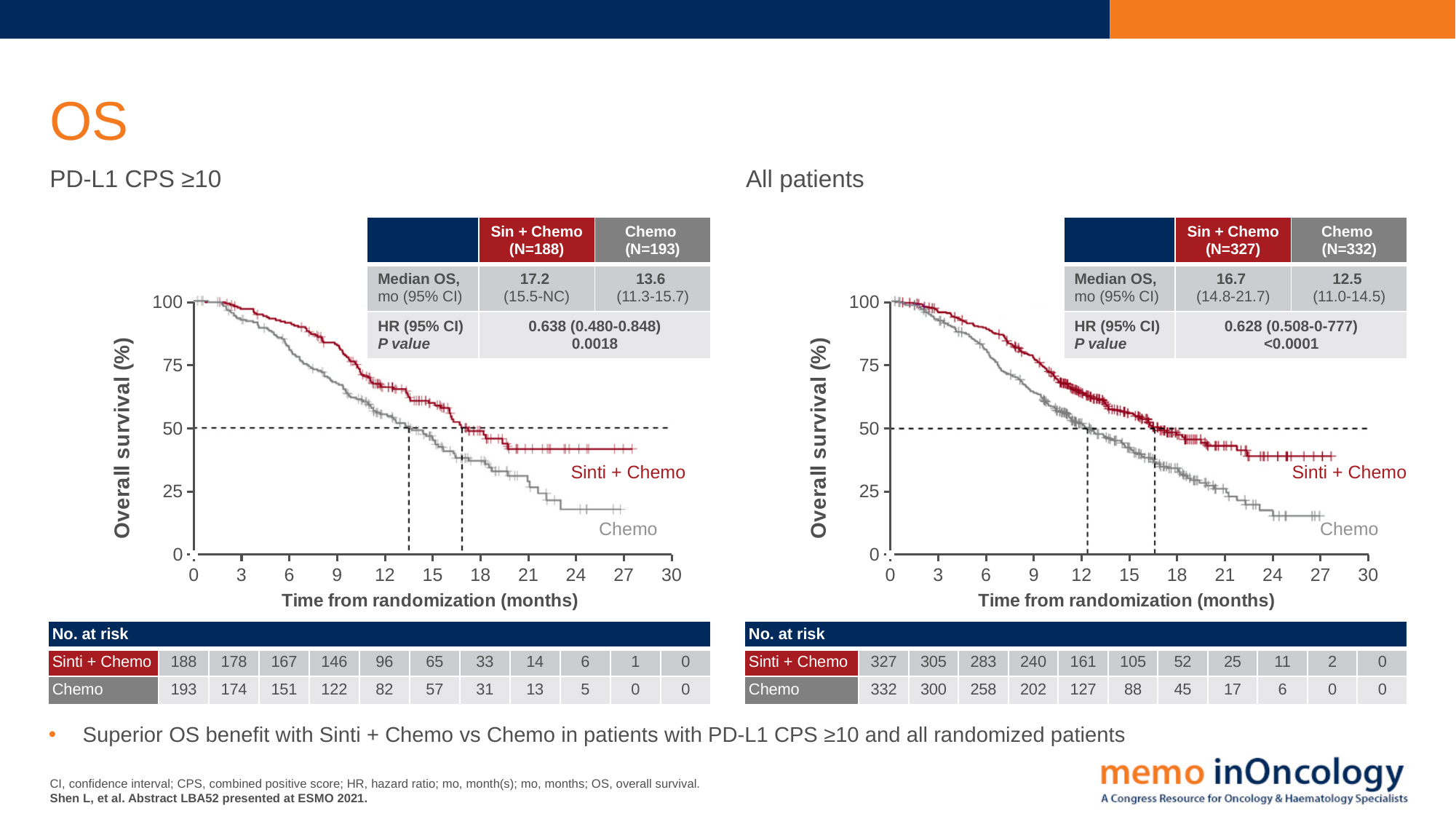
How many treatment arms are plotted in each chart? 2 In the PD-L1 CPS ≥10 chart, how many Chemo patients were at risk at 0 months? 193 In the All patients chart, what is the HR (95% CI)? 0.628 (0.508-0.777) In the PD-L1 CPS ≥10 chart, what is the P value? 0.0018 In the PD-L1 CPS ≥10 chart, what is the median OS in months for Sinti + Chemo? 17.2 In the All patients chart, how many Sinti + Chemo patients were at risk at 12 months? 161 In the PD-L1 CPS ≥10 chart, what is the median OS in months for Chemo? 13.6 In the All patients chart, what is the median OS in months for Sinti + Chemo? 16.7 In the All patients chart, which arm has the higher median OS? Sinti + Chemo In the All patients chart, what is the difference in median OS (months) between Sinti + Chemo and Chemo? 4.2 In the PD-L1 CPS ≥10 chart, what is the difference in median OS (months) between Sinti + Chemo and Chemo? 3.6 In the PD-L1 CPS ≥10 chart, is the overall survival for Sinti + Chemo at 24 months greater or less than 25%? greater